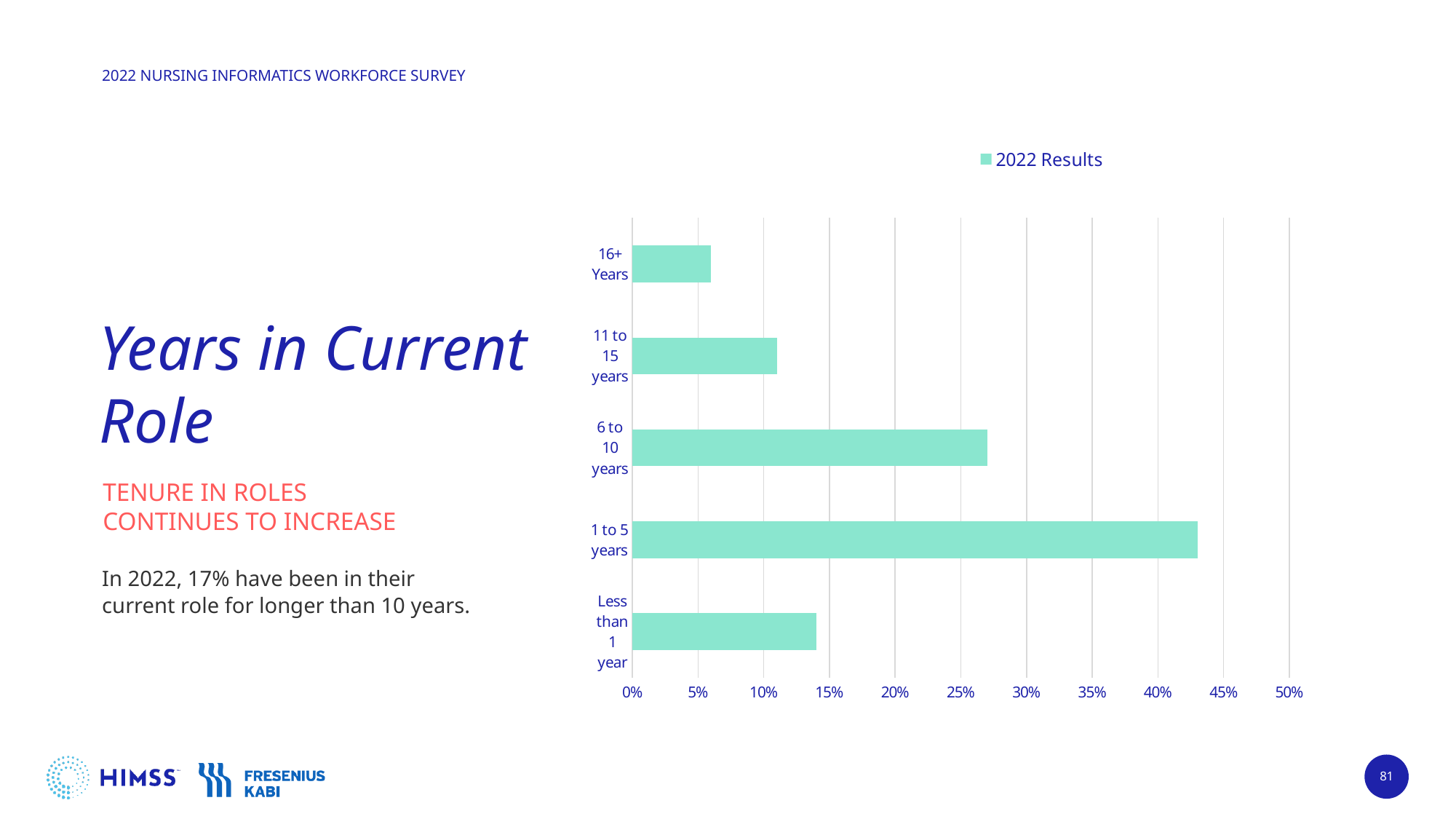
Which category has the lowest value on the chart? 16+ Years What is the name of the series shown in the chart legend? 2022 Results What kind of chart is shown on the slide? bar chart How many categories are plotted on the chart? 5 Is the value for 1 to 5 years greater or less than 40%? greater Which is larger, the value for 6 to 10 years or the value for Less than 1 year? 6 to 10 years Is the value for Less than 1 year greater or less than 10%? greater Which category has the highest value on the chart? 1 to 5 years How many series does the chart legend list? 1 Which is larger, the value for 11 to 15 years or the value for 16+ Years? 11 to 15 years Is the value for 11 to 15 years greater or less than 15%? less